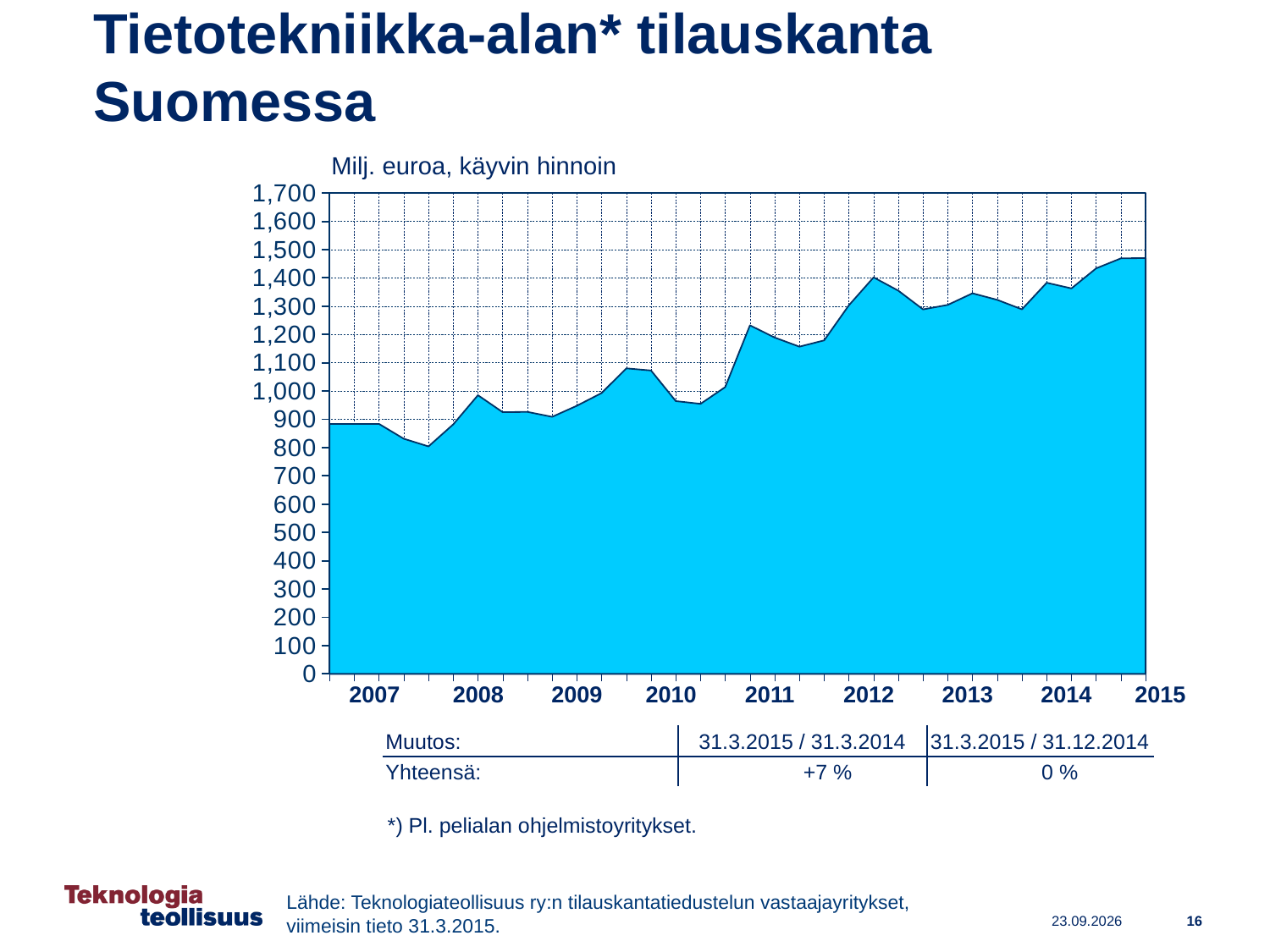
Is the value at the start of 2013 greater or less than 1,200? greater Overall, does the order backlog rise or fall from 2007 to 2015? rise In which year does the chart reach its highest value? 2015 What is the highest value shown on the vertical axis of the chart? 1,700 In which year does the chart reach its lowest value? 2007 What kind of chart is shown on the slide? area chart What unit is the chart's data expressed in, according to the label above the chart? Milj. euroa, käyvin hinnoin What is the last year labelled on the horizontal axis? 2015 How many years are labelled on the horizontal axis of the chart? 9 Is the value at the start of 2015 greater or less than 1,400? greater What is the first year labelled on the horizontal axis? 2007